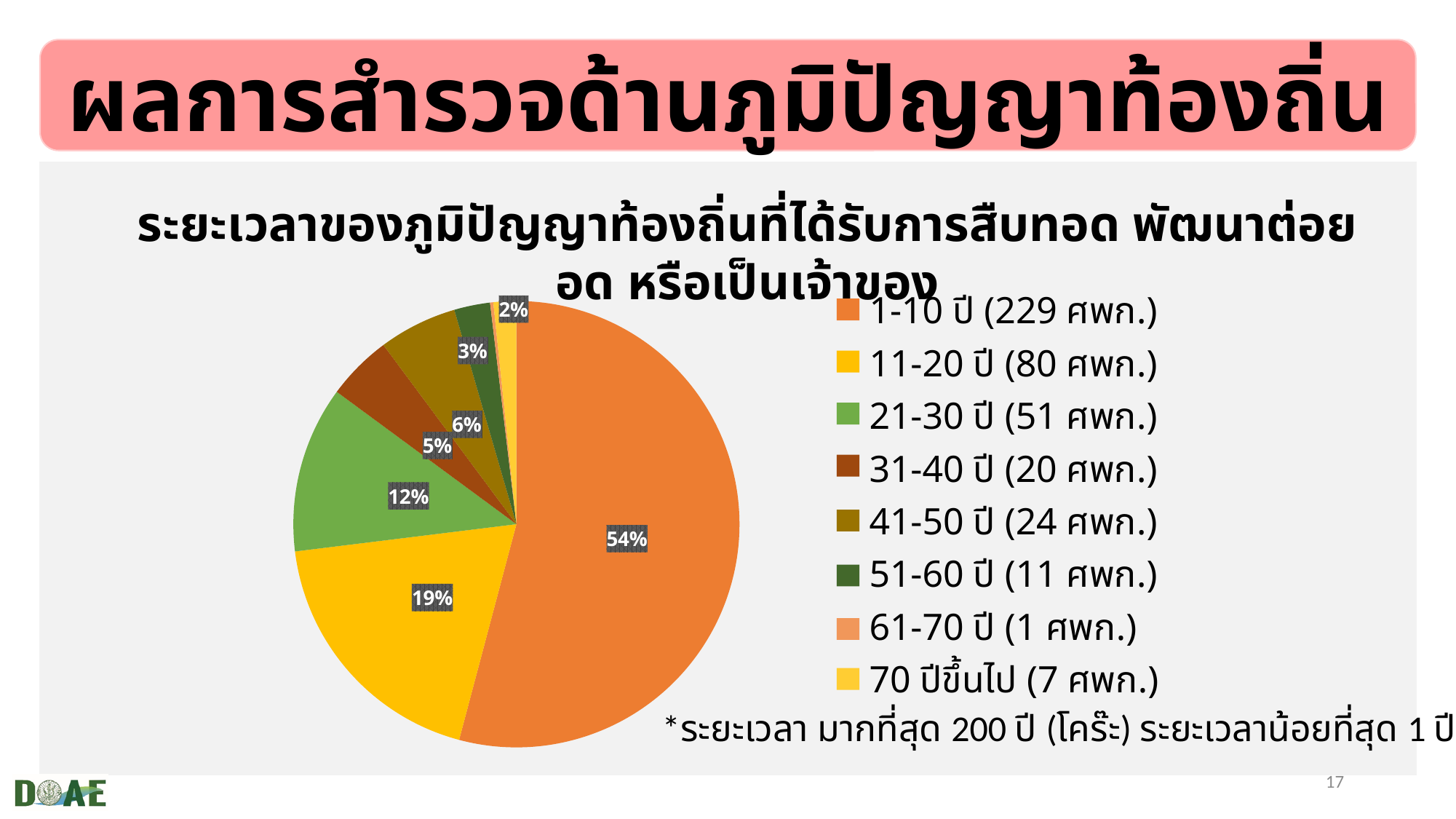
What colour is the 1-10 ปี slice? orange What percentage share does the 41-50 ปี slice have? 6% Which slice is larger, 31-40 ปี or 41-50 ปี? 41-50 ปี What is the difference in percentage points between the 1-10 ปี slice and the 11-20 ปี slice? 35 What percentage share does the 21-30 ปี slice have? 12% What percentage share does the 11-20 ปี slice have? 19% Which category has the largest slice of the pie? 1-10 ปี How many categories does the legend list? 8 What percentage share does the 1-10 ปี slice have? 54% What kind of chart is shown on the slide? pie chart According to the legend, how many ศพก. are in the 11-20 ปี category? 80 ศพก. What percentage share does the 51-60 ปี slice have? 3%